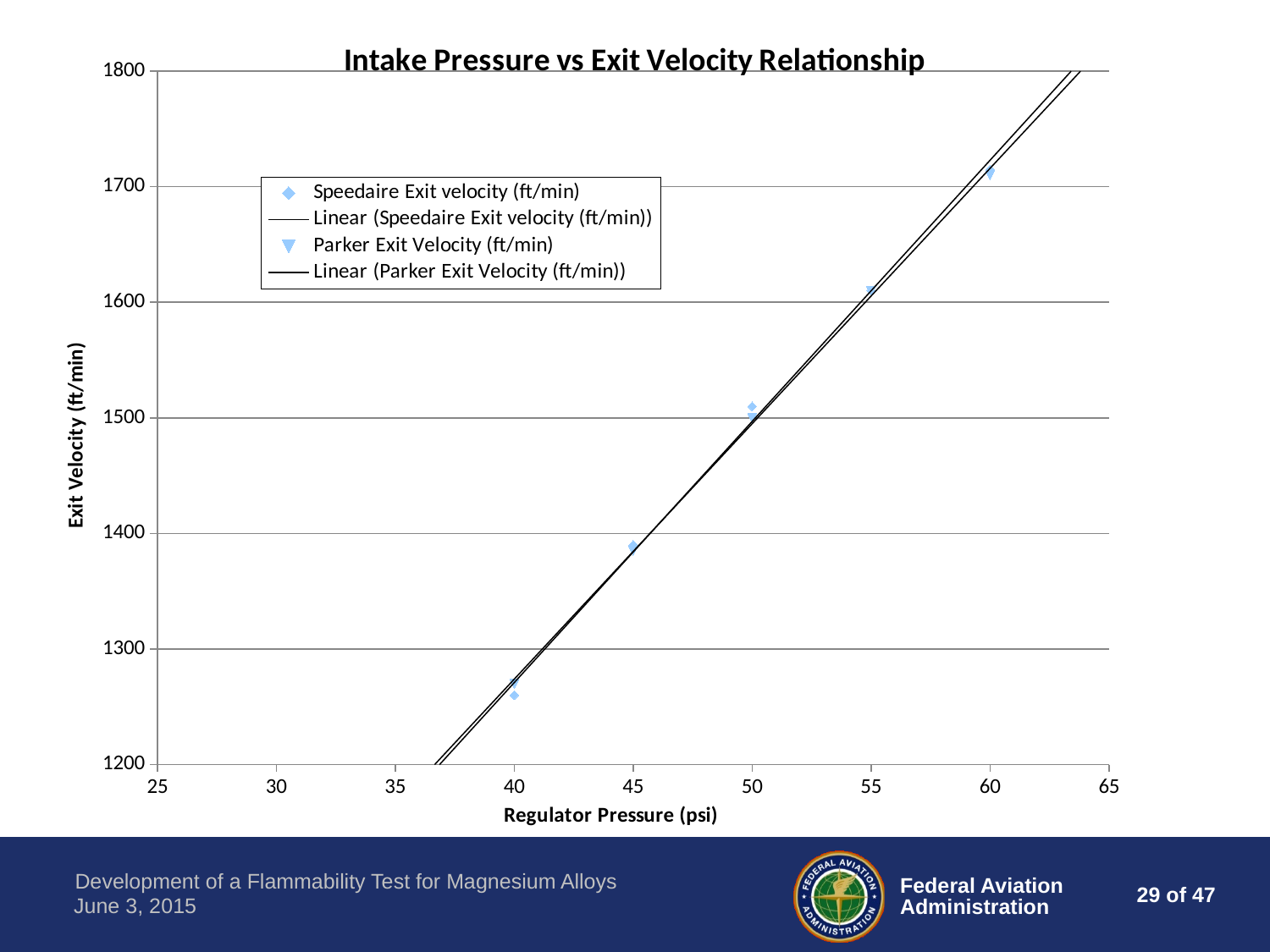
How many entries does the chart legend list? 4 Which is larger, the Parker exit velocity at 60 psi or at 40 psi? 60 psi Does exit velocity rise or fall as regulator pressure increases along the x axis? rise What is the title of the chart? Intake Pressure vs Exit Velocity Relationship How many data points are plotted for the Speedaire Exit velocity series? 5 Is the Speedaire exit velocity at 55 psi greater or less than 1700? less At which regulator pressure is the Speedaire exit velocity highest? 60 What kind of chart is shown on the slide? scatter chart What is the label of the x axis? Regulator Pressure (psi) Is the Speedaire exit velocity at 40 psi greater or less than 1300? less At which regulator pressure is the Parker exit velocity lowest? 40